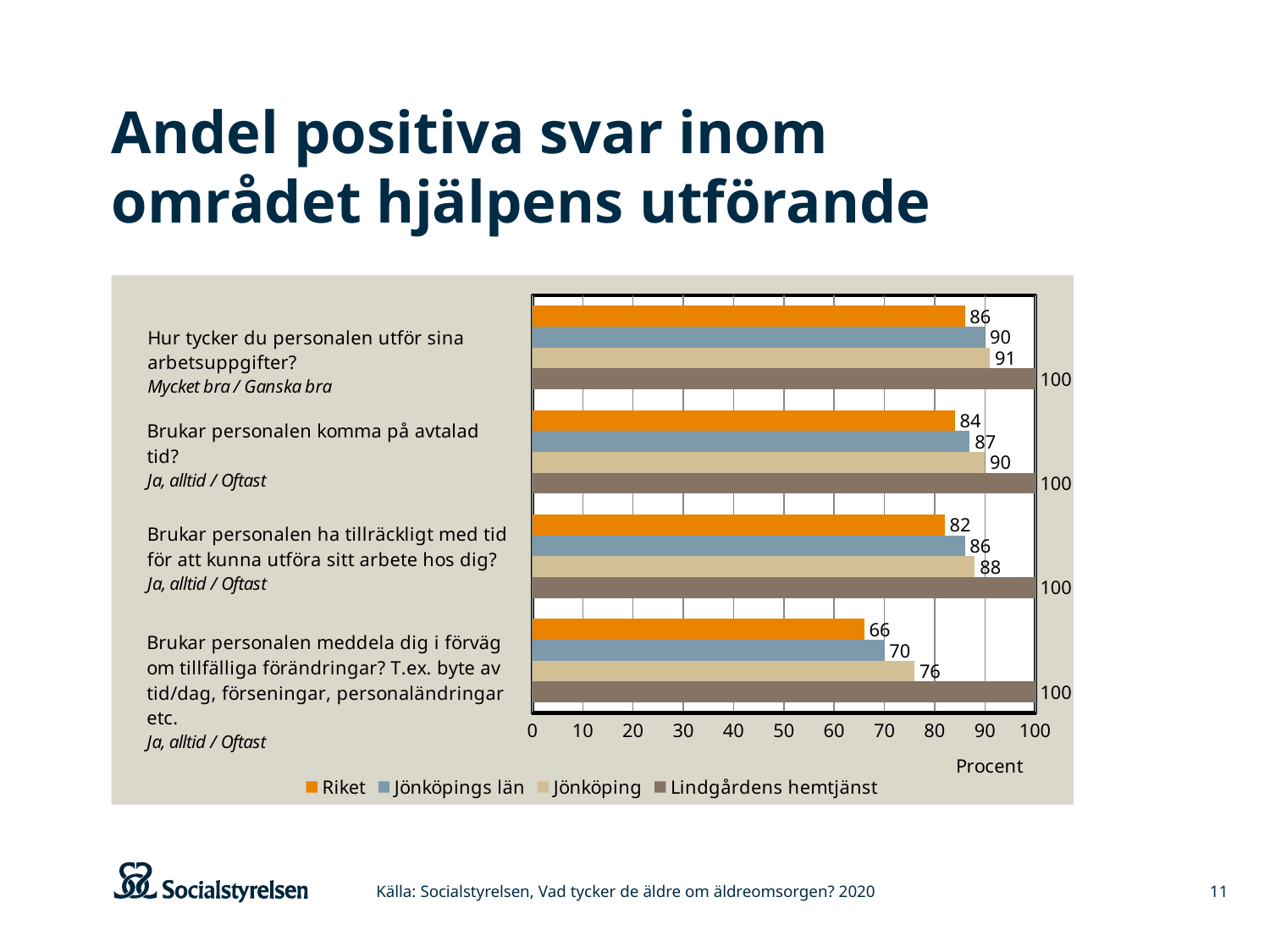
How many questions (categories) are shown in the chart? 4 Which question has the lowest value for Riket? Brukar personalen meddela dig i förväg om tillfälliga förändringar? What kind of chart is shown on the slide? Bar chart What is the value for Jönköping on the question "Brukar personalen komma på avtalad tid?"? 90 On the question "Brukar personalen komma på avtalad tid?", which is larger: Riket or Jönköpings län? Jönköpings län What is the value for Jönköpings län on the question "Brukar personalen ha tillräckligt med tid för att kunna utföra sitt arbete hos dig?"? 86 Is the value for Jönköping on the question "Brukar personalen meddela dig i förväg om tillfälliga förändringar?" greater or less than 80? less What unit is shown on the x axis of the chart? Procent What is the value for Lindgårdens hemtjänst on the question "Brukar personalen meddela dig i förväg om tillfälliga förändringar?"? 100 What is the difference between Jönköping and Riket on the question "Brukar personalen meddela dig i förväg om tillfälliga förändringar?"? 10 What is the value for Riket on the question "Hur tycker du personalen utför sina arbetsuppgifter?"? 86 How many series does the legend list? 4